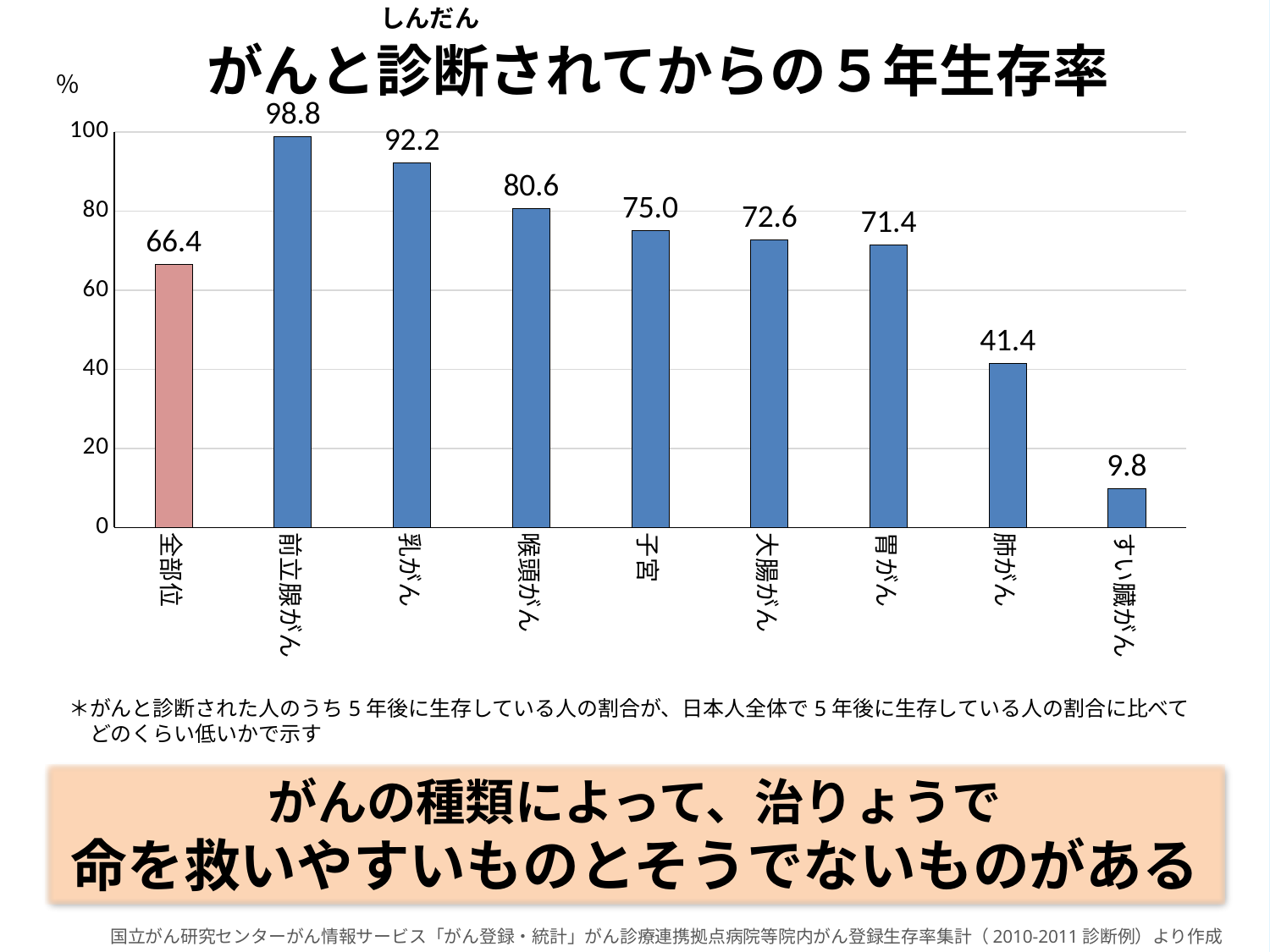
What is the value shown for すい臓がん? 9.8 What kind of chart is shown on the slide? bar chart Which category has the lowest 5-year survival rate? すい臓がん Is the value for 喉頭がん greater or less than 80? greater Which bar is coloured differently (pink) from the others? 全部位 How many categories are shown on the x axis? 9 What is the difference between the values for 乳がん and 胃がん? 20.8 Which is larger, the value for 子宮 or the value for 大腸がん? 子宮 What is the value shown for 全部位? 66.4 Which category has the highest 5-year survival rate? 前立腺がん What is the value shown for 肺がん? 41.4 What is the 5-year survival rate shown for 前立腺がん? 98.8